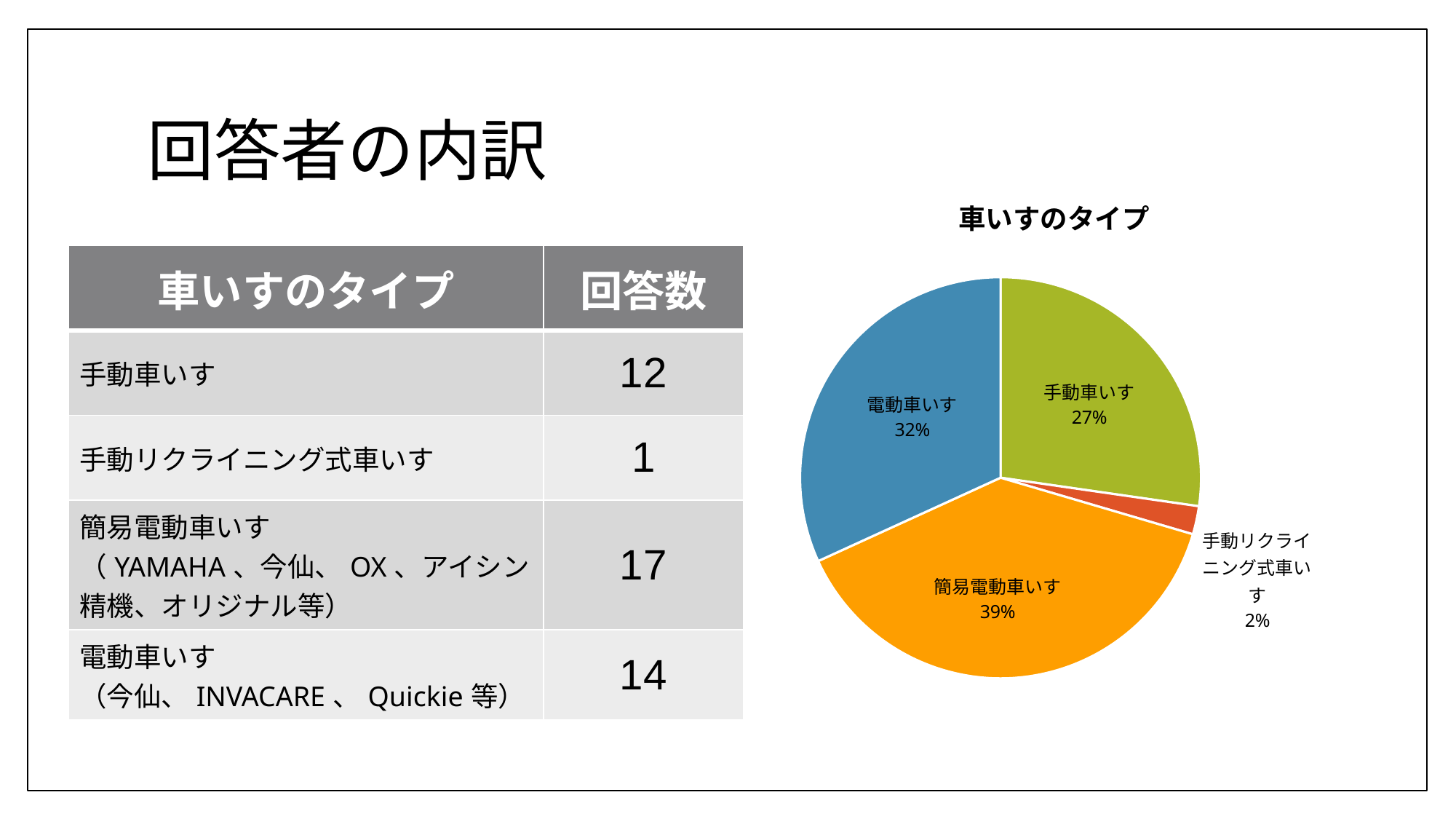
Which is larger in the pie chart, 電動車いす or 手動車いす? 電動車いす Which category has the smallest slice of the pie? 手動リクライニング式車いす What colour is the 簡易電動車いす slice in the pie chart? orange What is the difference in percentage points between 簡易電動車いす and 手動車いす? 12 What share of the pie does 手動車いす have? 27% What kind of chart is shown on the slide? pie chart How many slices does the pie chart have? 4 What is the title of the pie chart? 車いすのタイプ What share of the pie does 電動車いす have? 32% Which category has the largest slice of the pie? 簡易電動車いす What share of the pie does 簡易電動車いす have? 39%